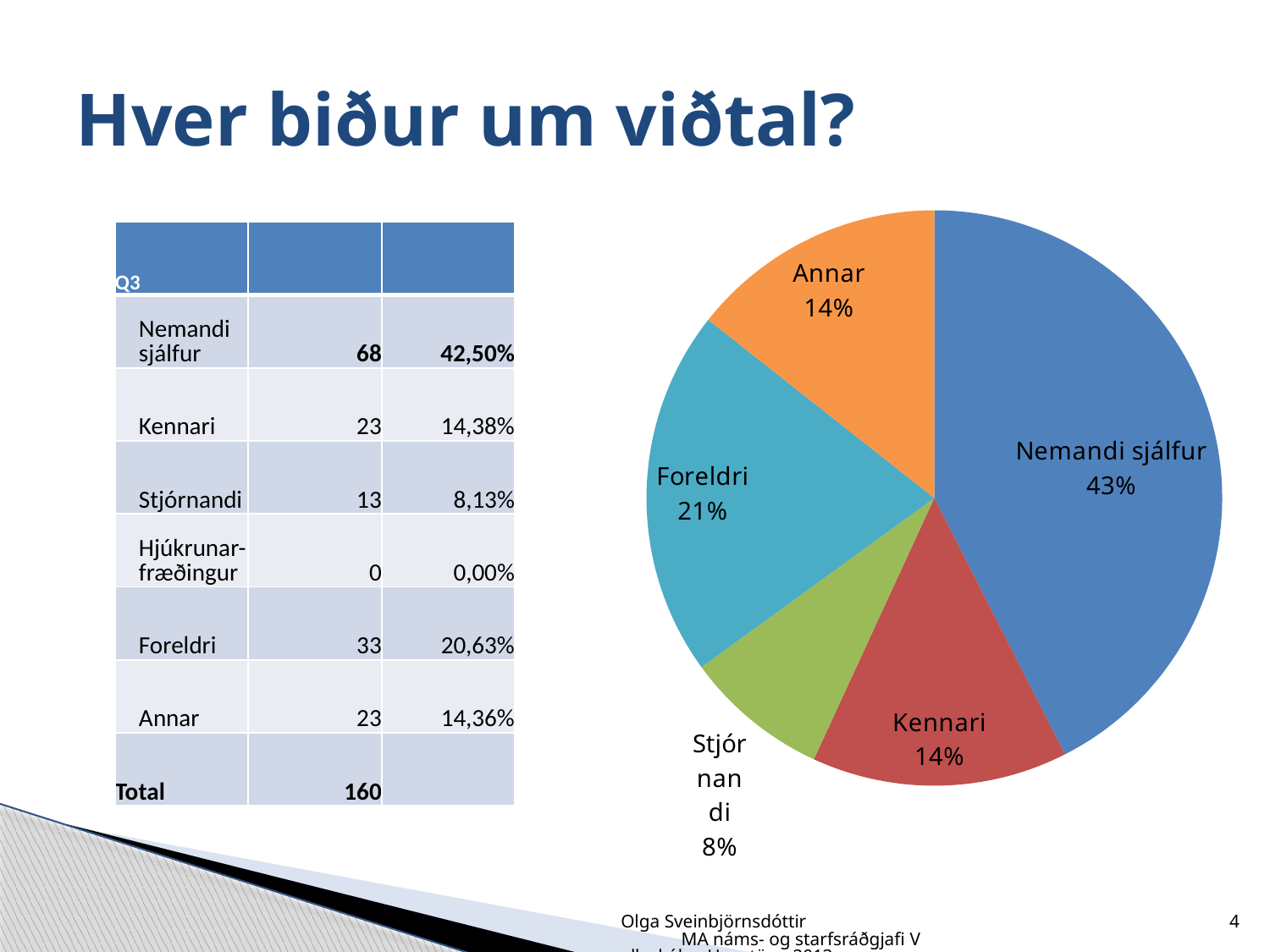
What share of the pie does Foreldri have? 21% What is the difference in percentage points between the Nemandi sjálfur slice and the Foreldri slice? 22 What share of the pie does Kennari have? 14% How many slices does the pie chart have? 5 What share of the pie does Stjórnandi have? 8% Which is larger in the pie chart, Foreldri or Kennari? Foreldri Which slice of the pie chart is the smallest? Stjórnandi What colour is the Foreldri slice in the pie chart? light blue Which slice of the pie chart is the largest? Nemandi sjálfur What kind of chart is shown on the slide? pie chart